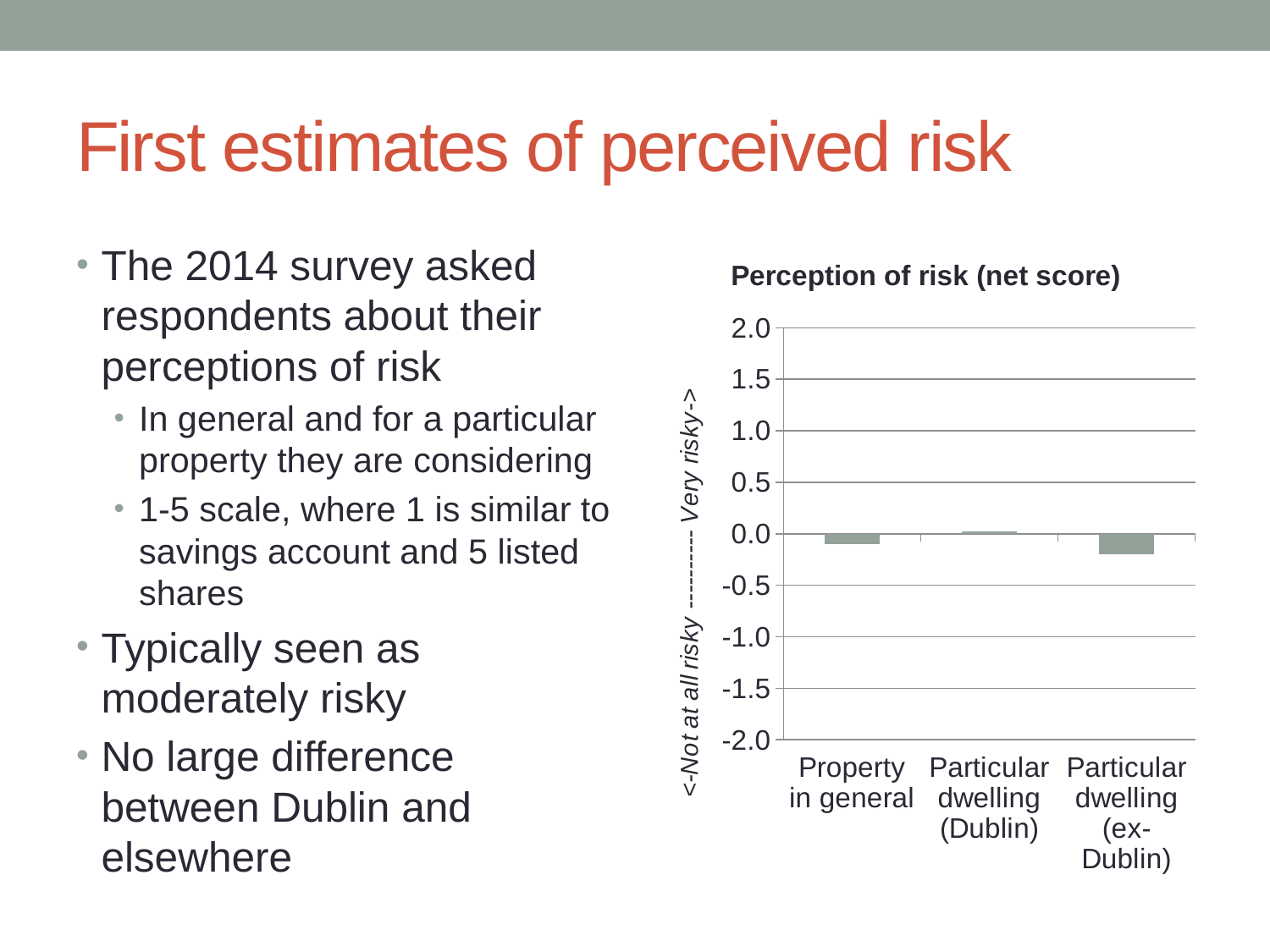
Which category has the highest net score? Particular dwelling (Dublin) How many categories are plotted on the chart? 3 Which category has the lowest net score? Particular dwelling (ex-Dublin) Is the value for Particular dwelling (Dublin) greater or less than 0.5? less Which is larger, the value for Property in general or the value for Particular dwelling (ex-Dublin)? Property in general Which is larger, the value for Particular dwelling (Dublin) or the value for Particular dwelling (ex-Dublin)? Particular dwelling (Dublin) Is the value for Particular dwelling (ex-Dublin) greater or less than -0.5? greater What is the title of the chart? Perception of risk (net score) Is the value for Property in general greater or less than 0.0? less What is the highest value shown on the vertical axis? 2.0 What kind of chart is shown on the slide? bar chart